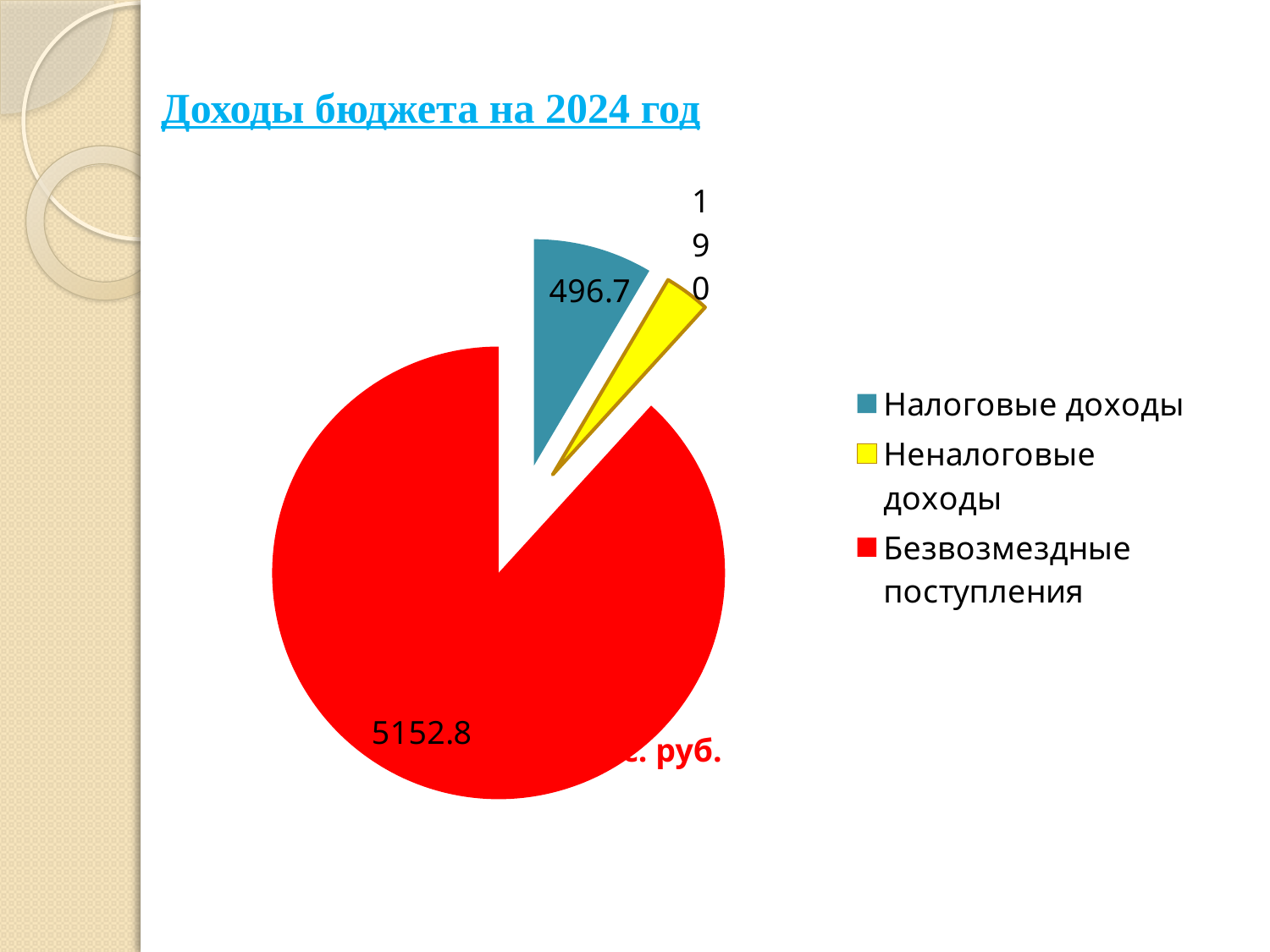
What type of chart is shown on the slide? pie chart Which category has the smallest slice? Неналоговые доходы What is the value for Безвозмездные поступления? 5152.8 How many entries does the legend list? 3 What is the value for Неналоговые доходы? 190 What is the value for Налоговые доходы? 496.7 What is the title of the chart? Доходы бюджета на 2024 год How many slices does the pie chart have? 3 Which category has the largest slice? Безвозмездные поступления Which is larger, Налоговые доходы or Неналоговые доходы? Налоговые доходы What colour is the slice for Безвозмездные поступления? red What is the difference between Безвозмездные поступления and Налоговые доходы? 4656.1